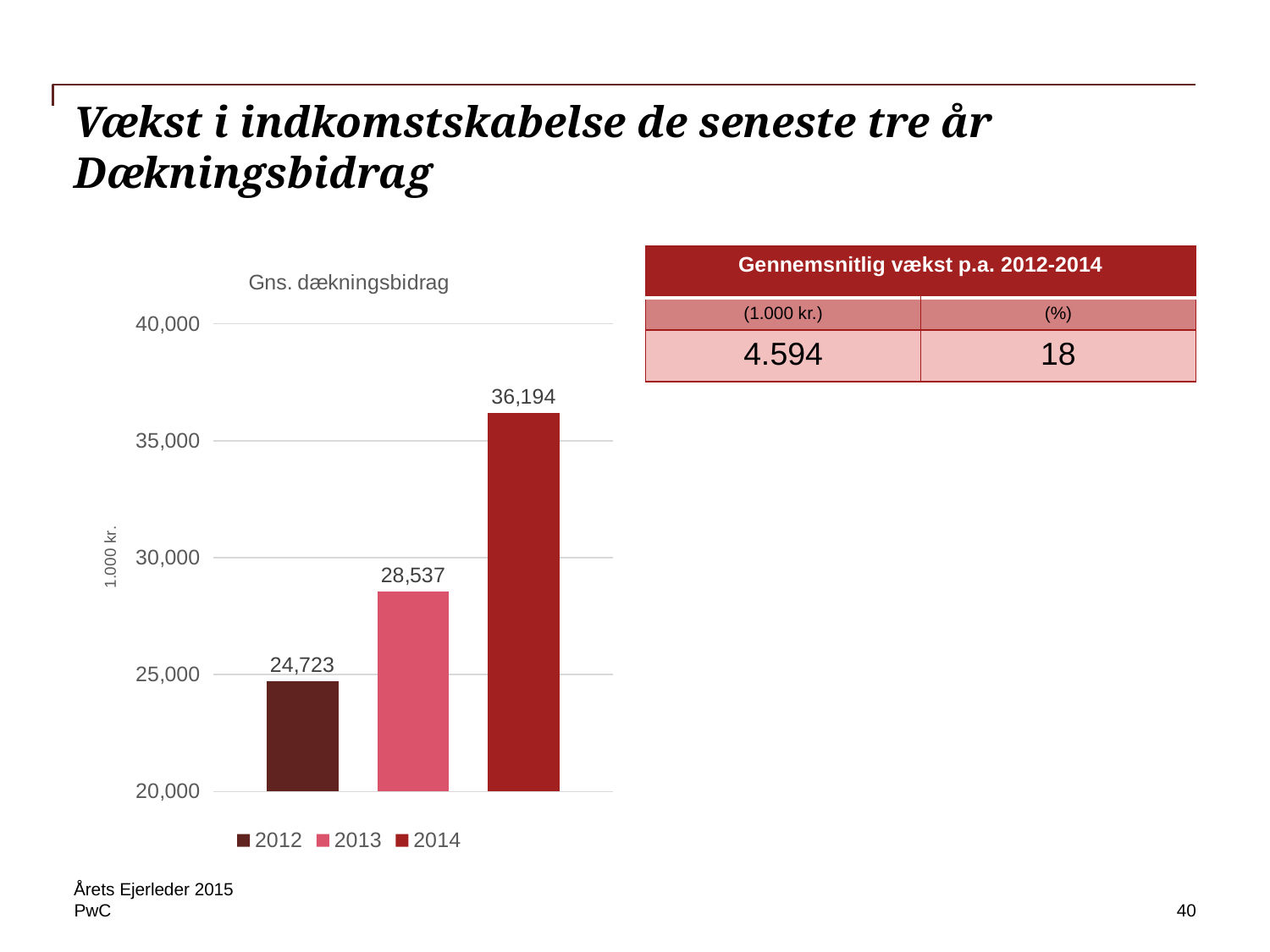
What is the difference between the 2014 and 2012 values in the Gns. dækningsbidrag chart? 11,471 What is the value for 2012 in the Gns. dækningsbidrag chart? 24,723 Is the value for 2013 in the Gns. dækningsbidrag chart greater or less than 30,000? less What is the value for 2014 in the Gns. dækningsbidrag chart? 36,194 Do the values in the Gns. dækningsbidrag chart rise or fall from 2012 to 2014? rise What is the value for 2013 in the Gns. dækningsbidrag chart? 28,537 What is the difference between the 2013 and 2012 values in the Gns. dækningsbidrag chart? 3,814 Which year has the lowest value in the Gns. dækningsbidrag chart? 2012 Which is larger in the Gns. dækningsbidrag chart, the value for 2013 or the value for 2014? 2014 Which year has the highest value in the Gns. dækningsbidrag chart? 2014 How many bars are shown in the Gns. dækningsbidrag chart? 3 What kind of chart is the Gns. dækningsbidrag chart? bar chart